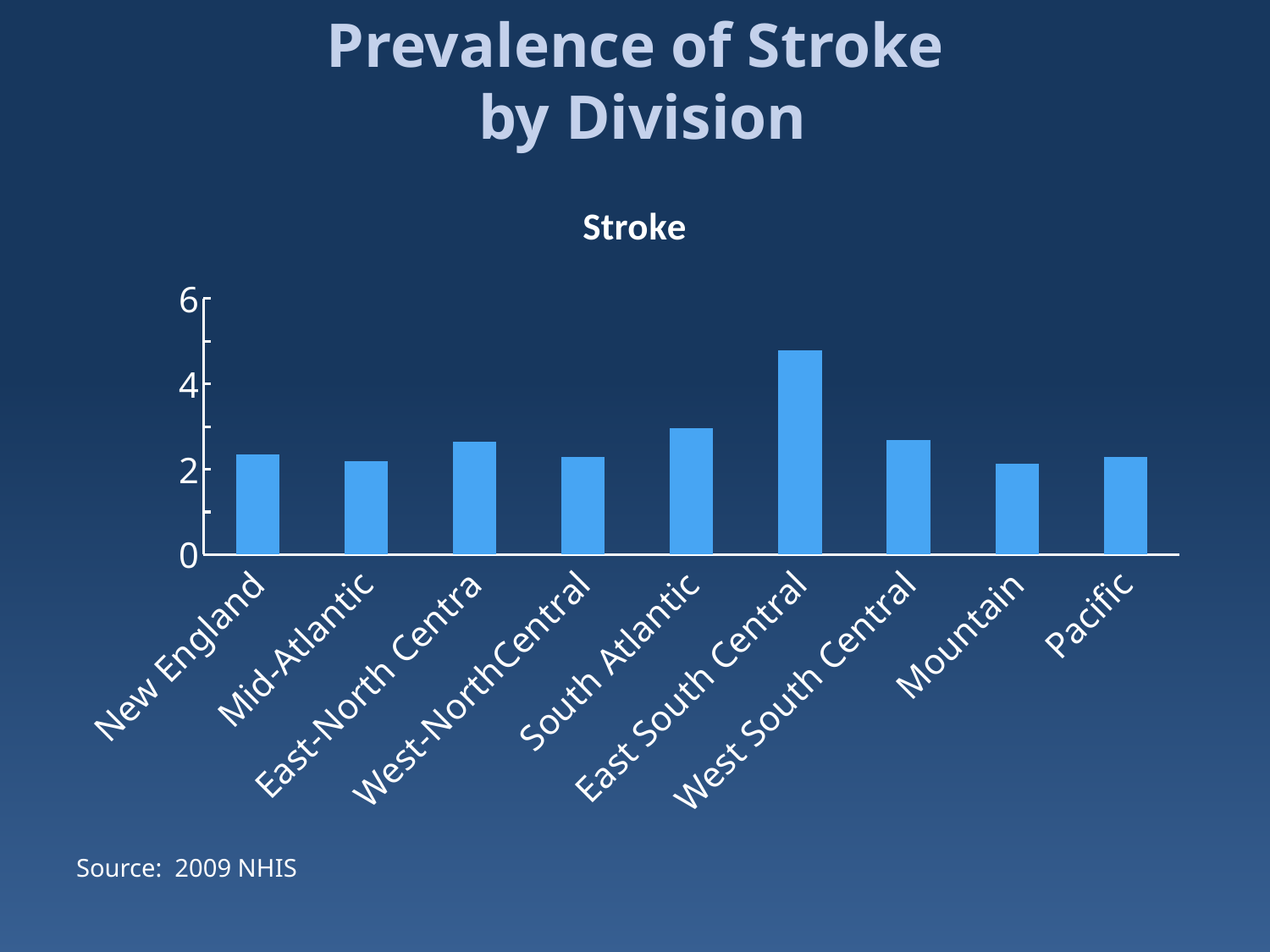
What is the title of the slide? Prevalence of Stroke by Division Is the value for South Atlantic greater or less than 2? greater Which division has the highest stroke prevalence in the chart? East South Central How many divisions are shown on the x axis of the chart? 9 Which is larger, the value for South Atlantic or the value for Mid-Atlantic? South Atlantic Which is larger, the value for East South Central or the value for South Atlantic? East South Central What source is cited for the chart data? 2009 NHIS Which is larger, the value for East South Central or the value for Pacific? East South Central Is the value for East South Central greater or less than 4? greater Is the value for West South Central greater or less than 4? less What kind of chart is shown on the slide? bar chart